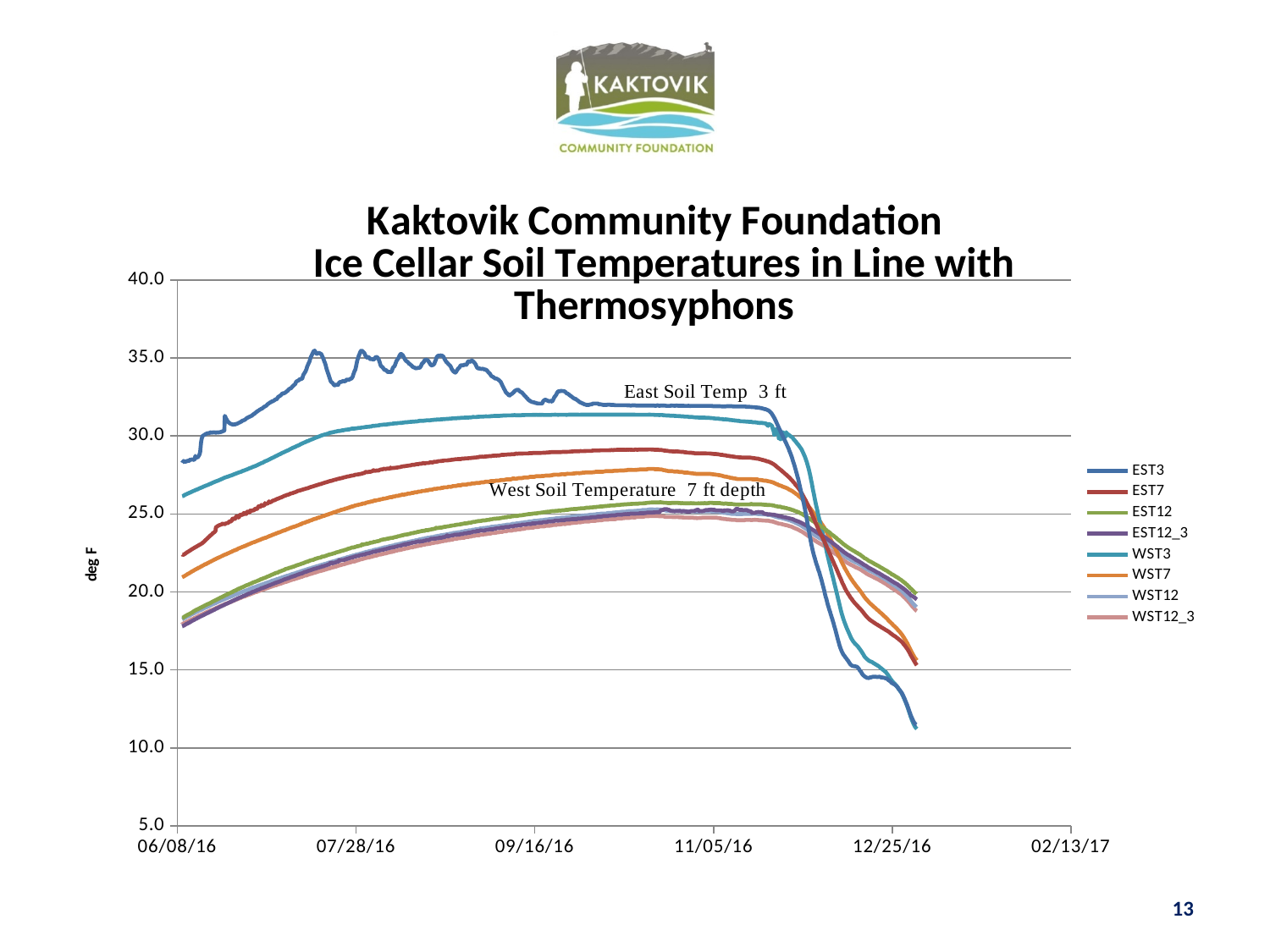
Which series has the highest value at 06/08/16? EST3 Is the value of EST3 at 07/28/16 greater or less than 30.0? greater Does the EST3 line rise or fall between 11/05/16 and 12/25/16? fall At 09/16/16, which series has the higher value, EST7 or WST7? EST7 Is the value of WST7 at 09/16/16 greater or less than 25.0? greater At 06/08/16, which series has the higher value, EST3 or EST7? EST3 What is the first line of the chart title? Kaktovik Community Foundation How many series does the legend list? 8 What is the label on the vertical axis? deg F Is the value of EST12 at 06/08/16 greater or less than 20.0? less What kind of chart is shown on the slide? line chart